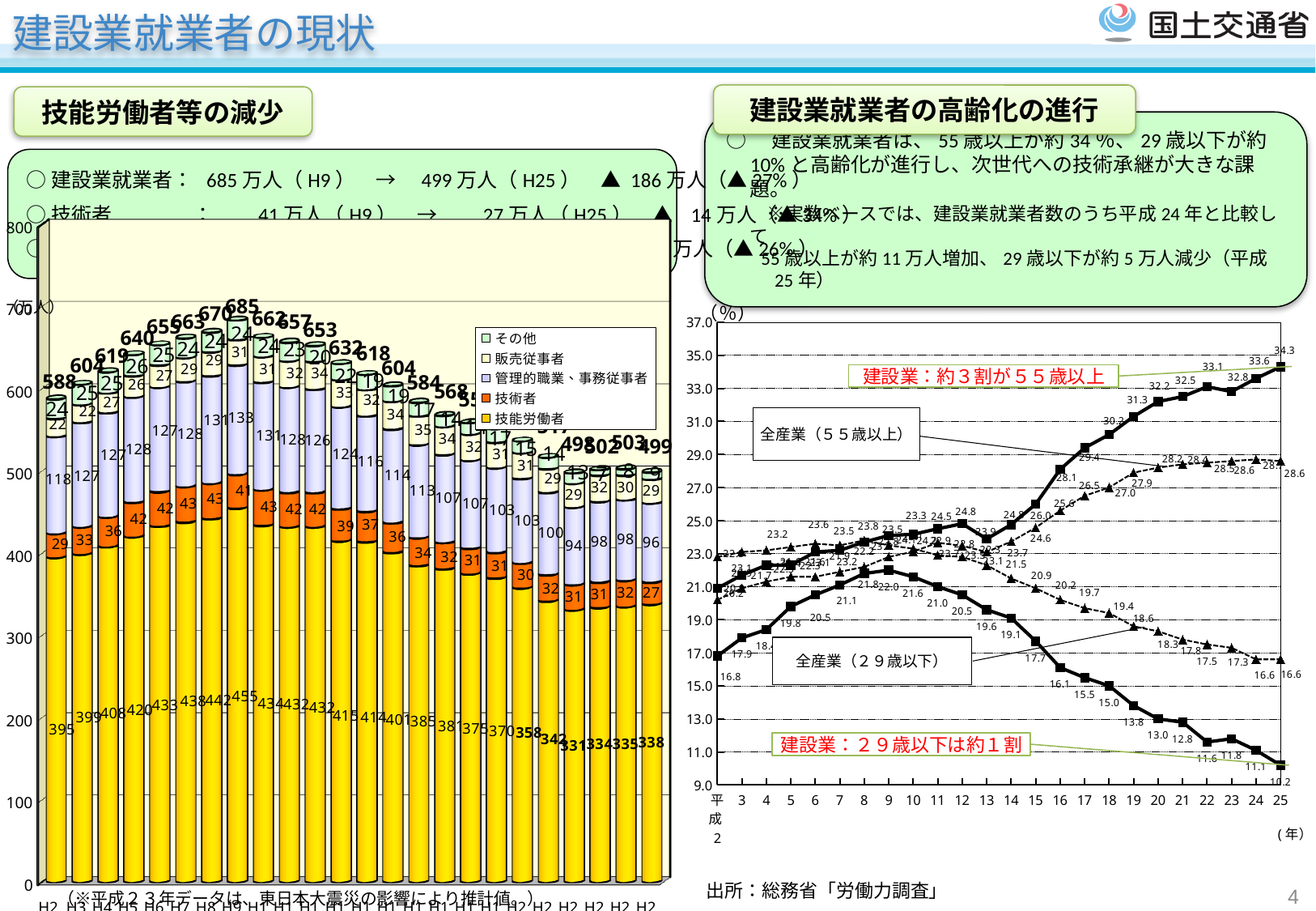
How many series does the legend of the left chart list? 5 In the left chart, what is the 技能労働者 value in the tallest bar (total 685)? 455 In the left chart, what is the difference between the highest bar total (685) and the rightmost bar total (499)? 186 In the right chart, what is the value of the construction industry 55-and-over line at 平成25? 34.3 In the left chart, what is the highest total labeled above a bar? 685 In the left chart, what is the total labeled above the last (rightmost) bar? 499 In the right chart, what is the value of the construction industry 29-and-under line at 平成25? 10.2 In the right chart, does the construction industry 29-and-under line rise or fall from 平成9 to 平成25? Fall What kind of chart is the chart on the left side of the slide? Stacked bar chart What kind of chart is the chart on the right side of the slide? Line chart In the right chart, at 平成25, which is larger: the construction industry 55-and-over share (34.3) or the all-industries 55-and-over share (28.6)? Construction industry (34.3) In the left chart, what is the total labeled above the first (leftmost) bar? 588